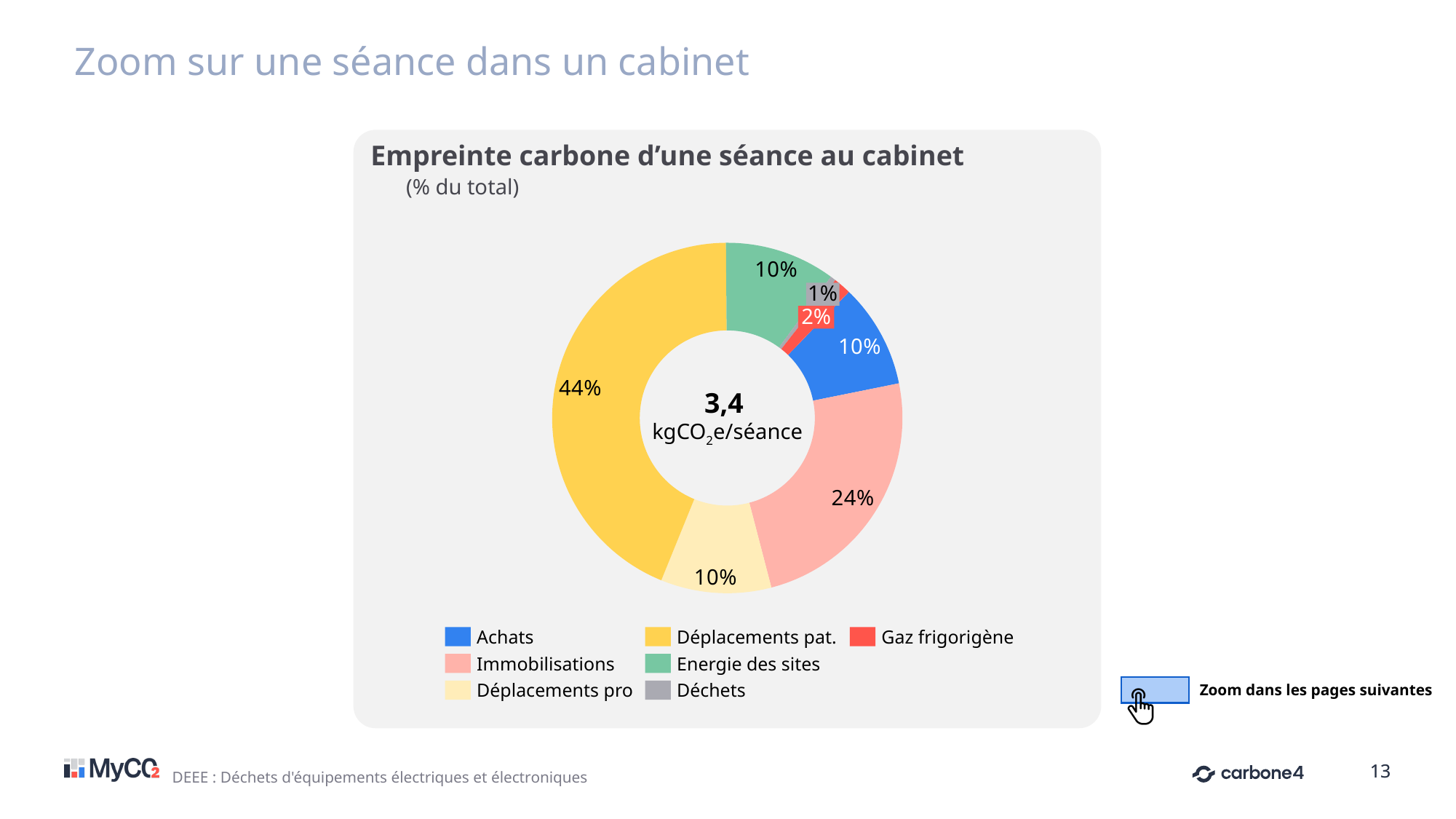
What total value is shown in the centre of the donut chart? 3,4 kgCO2e/séance What share of the carbon footprint does Immobilisations represent? 24% What share of the carbon footprint does Déplacements pat. represent? 44% Which category has the largest share of the carbon footprint? Déplacements pat. How many categories does the legend list? 7 What type of chart is shown on the slide? Pie chart (donut) Which is larger, the share for Immobilisations or the share for Achats? Immobilisations What is the title of the chart? Empreinte carbone d'une séance au cabinet What is the difference in percentage points between Déplacements pat. and Immobilisations? 20 What share of the carbon footprint does Gaz frigorigène represent? 2% What share of the carbon footprint does Déchets represent? 1% Which category has the smallest share of the carbon footprint? Déchets